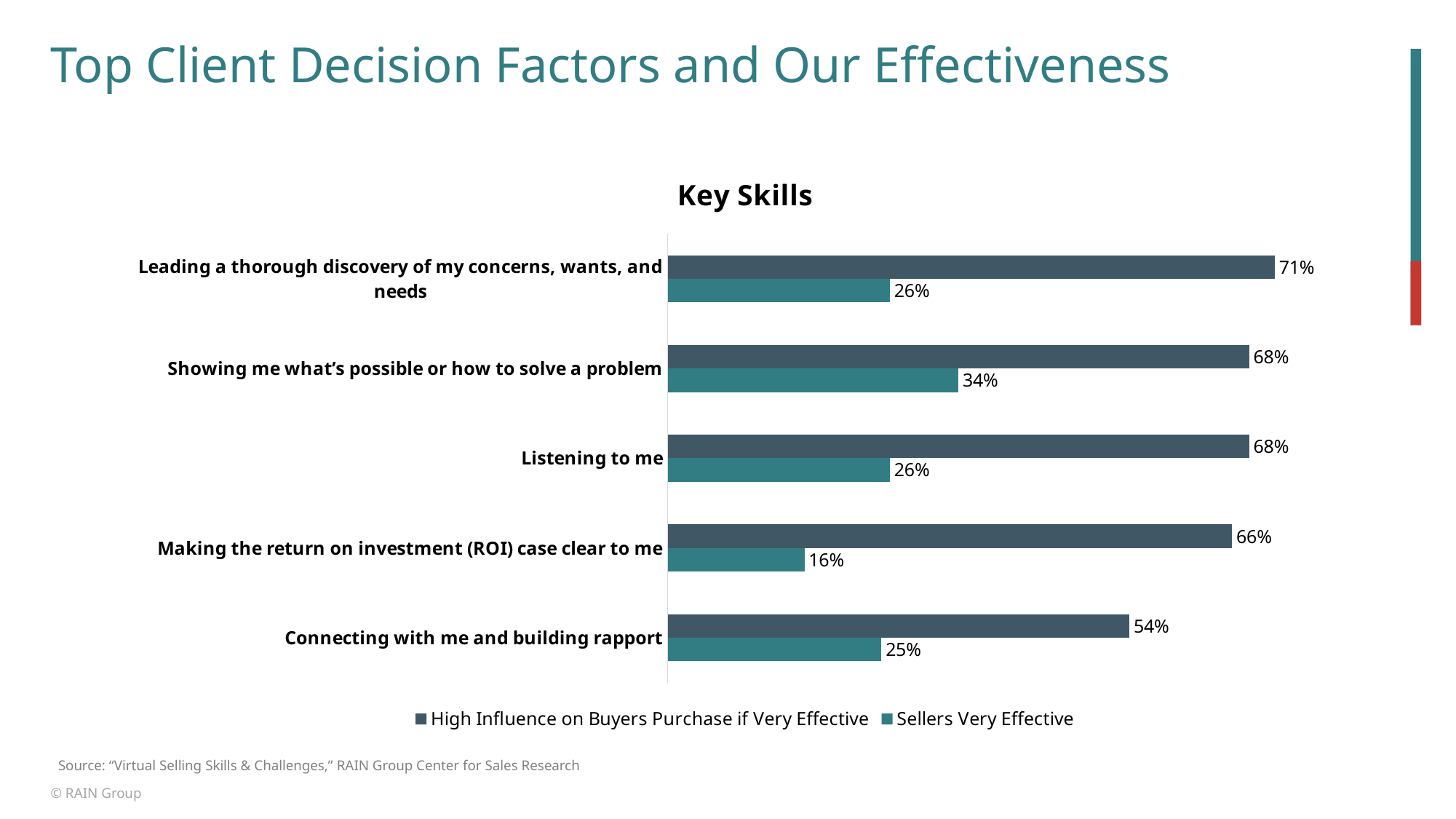
Which category has the highest value for "High Influence on Buyers Purchase if Very Effective"? Leading a thorough discovery of my concerns, wants, and needs What is the difference between the "High Influence on Buyers Purchase if Very Effective" value and the "Sellers Very Effective" value for "Leading a thorough discovery of my concerns, wants, and needs"? 45% What is the value for "High Influence on Buyers Purchase if Very Effective" for "Listening to me"? 68% What is the value for "Sellers Very Effective" for "Showing me what's possible or how to solve a problem"? 34% What is the value for "Sellers Very Effective" for "Making the return on investment (ROI) case clear to me"? 16% What is the difference between the "High Influence on Buyers Purchase if Very Effective" value and the "Sellers Very Effective" value for "Making the return on investment (ROI) case clear to me"? 50% What kind of chart is shown on the slide? Bar chart Which is larger: the "Sellers Very Effective" value for "Showing me what's possible or how to solve a problem" or for "Connecting with me and building rapport"? Showing me what's possible or how to solve a problem Which category has the lowest value for "High Influence on Buyers Purchase if Very Effective"? Connecting with me and building rapport Which category has the lowest value for "Sellers Very Effective"? Making the return on investment (ROI) case clear to me How many categories are shown in the chart? 5 How many series does the legend list? 2